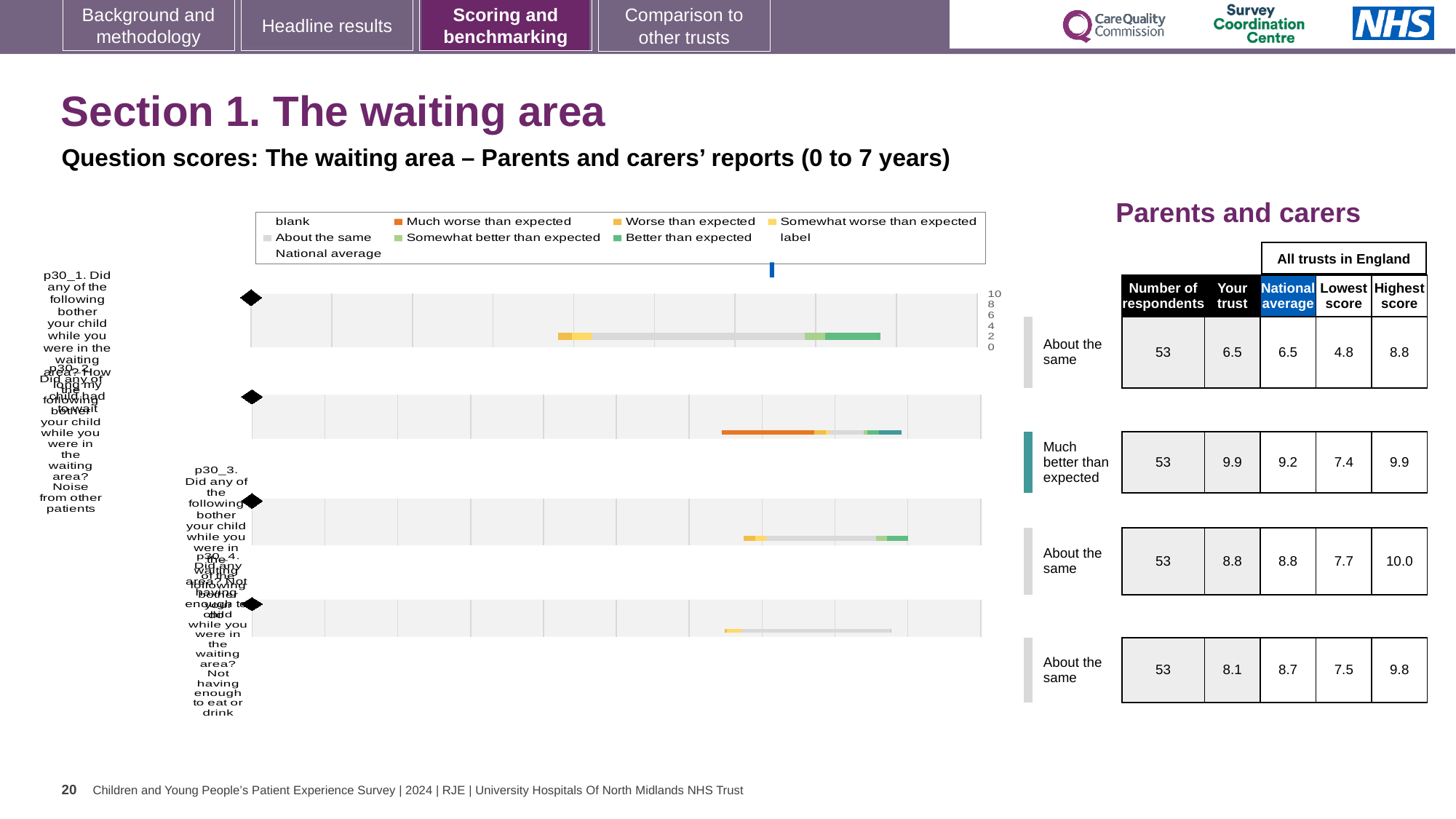
In the table next to the chart, which question row has the lowest 'Your trust' score? the first row (6.5) How many entries does the chart legend list? 9 In the table next to the chart, how many respondents are listed for each question? 53 Which legend entry is shown in orange? Much worse than expected In the table next to the chart, which question row has the highest 'Your trust' score? the second row (9.9) Which legend entry is shown in dark green? Better than expected What kind of chart is used on this slide to show the question scores? bar chart In the table next to the chart, what is the national average for the first question row? 6.5 How many question rows (bars) are plotted in the chart? 4 In the table next to the chart, what is the 'Your trust' score for the second question row (Much better than expected)? 9.9 In the table next to the chart, is the 'Your trust' score for the fourth row (8.1) larger or smaller than its national average (8.7)? smaller What is the highest value shown on the chart's axis? 10